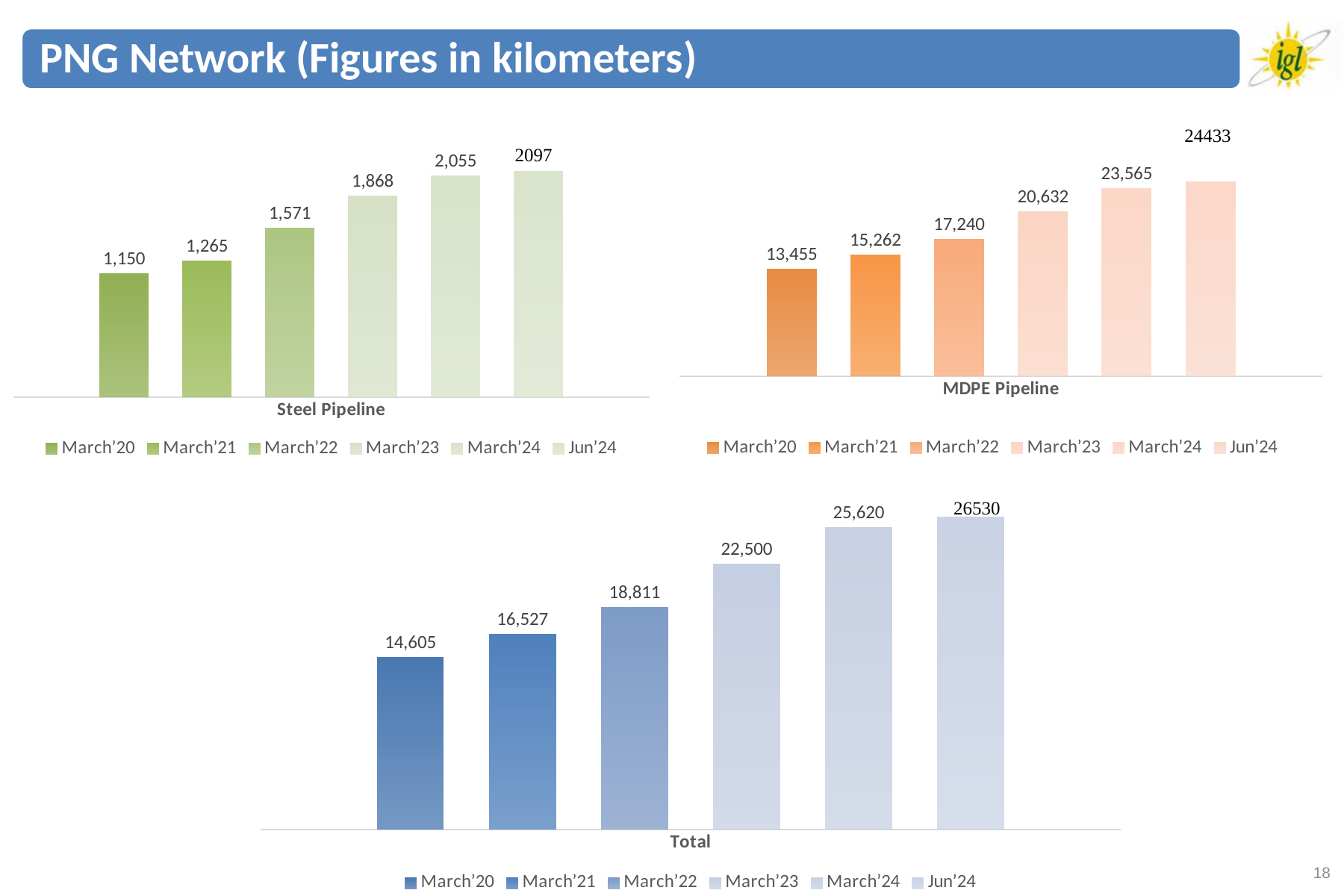
In the Steel Pipeline chart, what is the value for March'22? 1,571 What kind of chart is the Steel Pipeline chart? bar chart In the Total chart, what is the difference between the March'24 and March'23 values? 3,120 In the Total chart, do the values rise or fall from March'20 to Jun'24? rise How many entries does the legend of the Total chart list? 6 In the MDPE Pipeline chart, which is larger, the value for March'21 or the value for March'22? March'22 In the Steel Pipeline chart, which period has the lowest value? March'20 How many bars are plotted in the MDPE Pipeline chart? 6 In the Total chart, what is the value for Jun'24? 26530 In the MDPE Pipeline chart, what is the value for March'23? 20,632 In the Steel Pipeline chart, what is the difference between the March'21 and March'20 values? 115 In the MDPE Pipeline chart, which period has the highest value? Jun'24